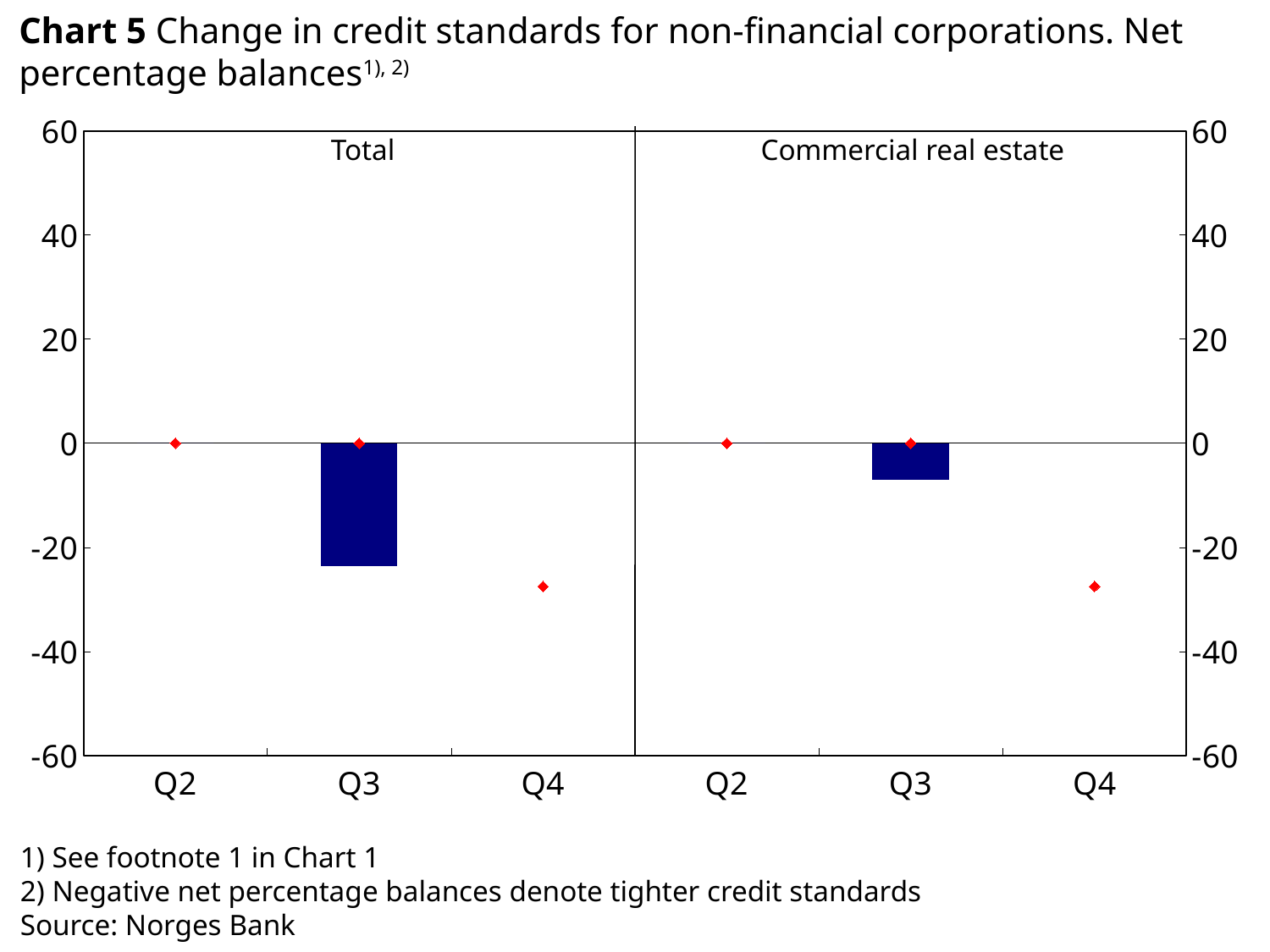
What kind of chart is shown on the slide? bar chart What is the source given for the chart? Norges Bank How many panels does the chart have? 2 What is the title of the right-hand panel? Commercial real estate In the Total panel, is the Q4 red marker greater or less than -20? less In the Total panel, is the Q3 bar greater or less than -20? less In the Total panel, do the red markers rise or fall from Q2 to Q4? fall How many quarters are shown on the x axis of the Total panel? 3 In the Commercial real estate panel, is the Q3 bar greater or less than -20? greater In the Total panel, what value does the Q2 red marker sit on? 0 Which panel has the lower (more negative) Q3 bar, Total or Commercial real estate? Total